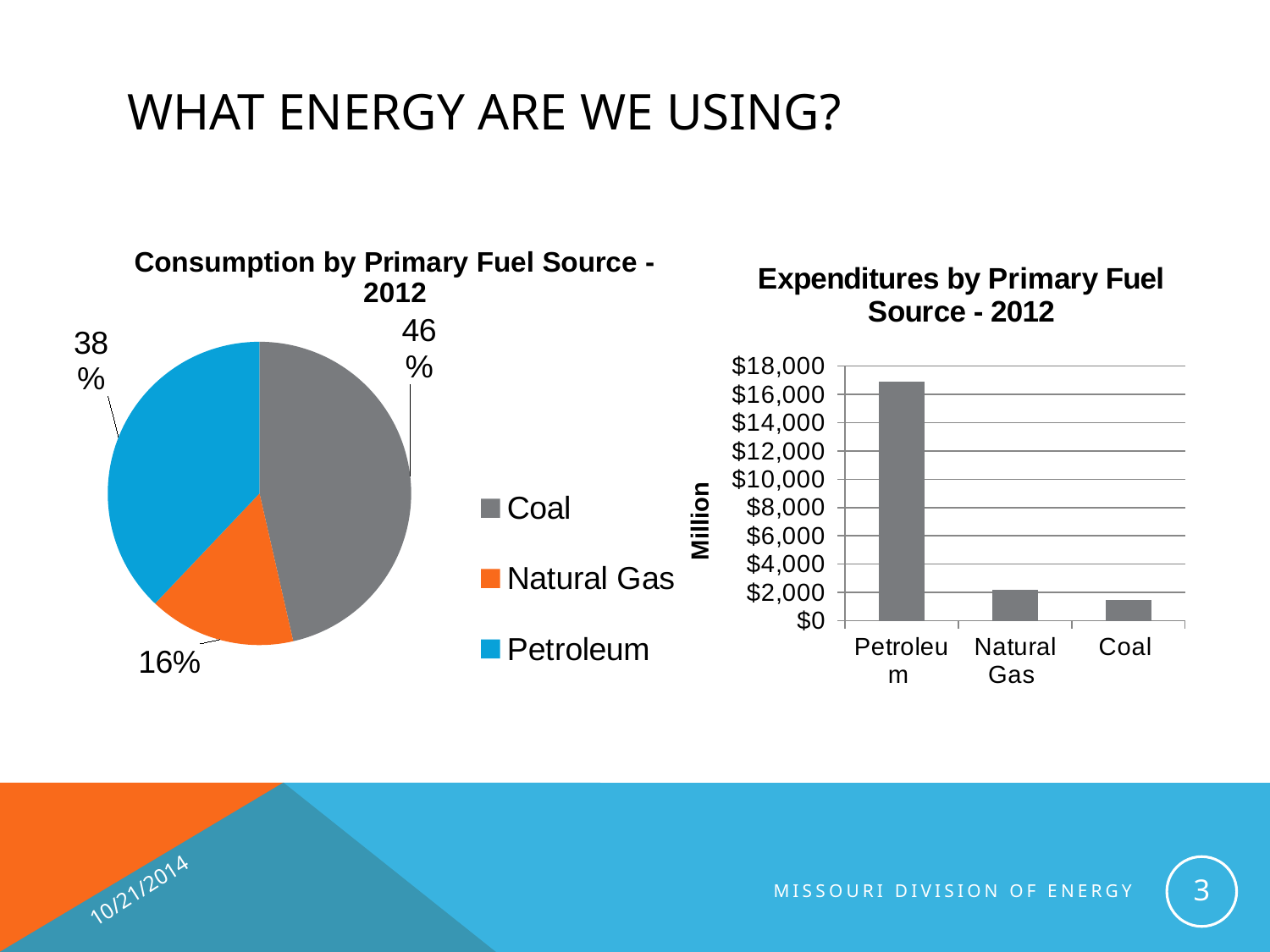
In the 'Expenditures by Primary Fuel Source - 2012' chart, is the value for Petroleum greater or less than $16,000? greater In the 'Consumption by Primary Fuel Source - 2012' pie chart, which fuel source has the largest share? Coal In the 'Consumption by Primary Fuel Source - 2012' pie chart, what is the difference between the Coal share and the Petroleum share? 8% In the 'Expenditures by Primary Fuel Source - 2012' chart, what is the label on the vertical axis? Million In the 'Consumption by Primary Fuel Source - 2012' pie chart, which fuel source has the smallest share? Natural Gas In the 'Consumption by Primary Fuel Source - 2012' pie chart, what share does Coal have? 46% What type of chart is 'Expenditures by Primary Fuel Source - 2012'? bar chart In the 'Expenditures by Primary Fuel Source - 2012' chart, which fuel source has the highest expenditure? Petroleum In the 'Consumption by Primary Fuel Source - 2012' pie chart, how many fuel sources does the legend list? 3 In the 'Consumption by Primary Fuel Source - 2012' pie chart, what share does Natural Gas have? 16% In the 'Consumption by Primary Fuel Source - 2012' pie chart, what share does Petroleum have? 38% In the 'Expenditures by Primary Fuel Source - 2012' chart, is the value for Coal greater or less than $2,000? less